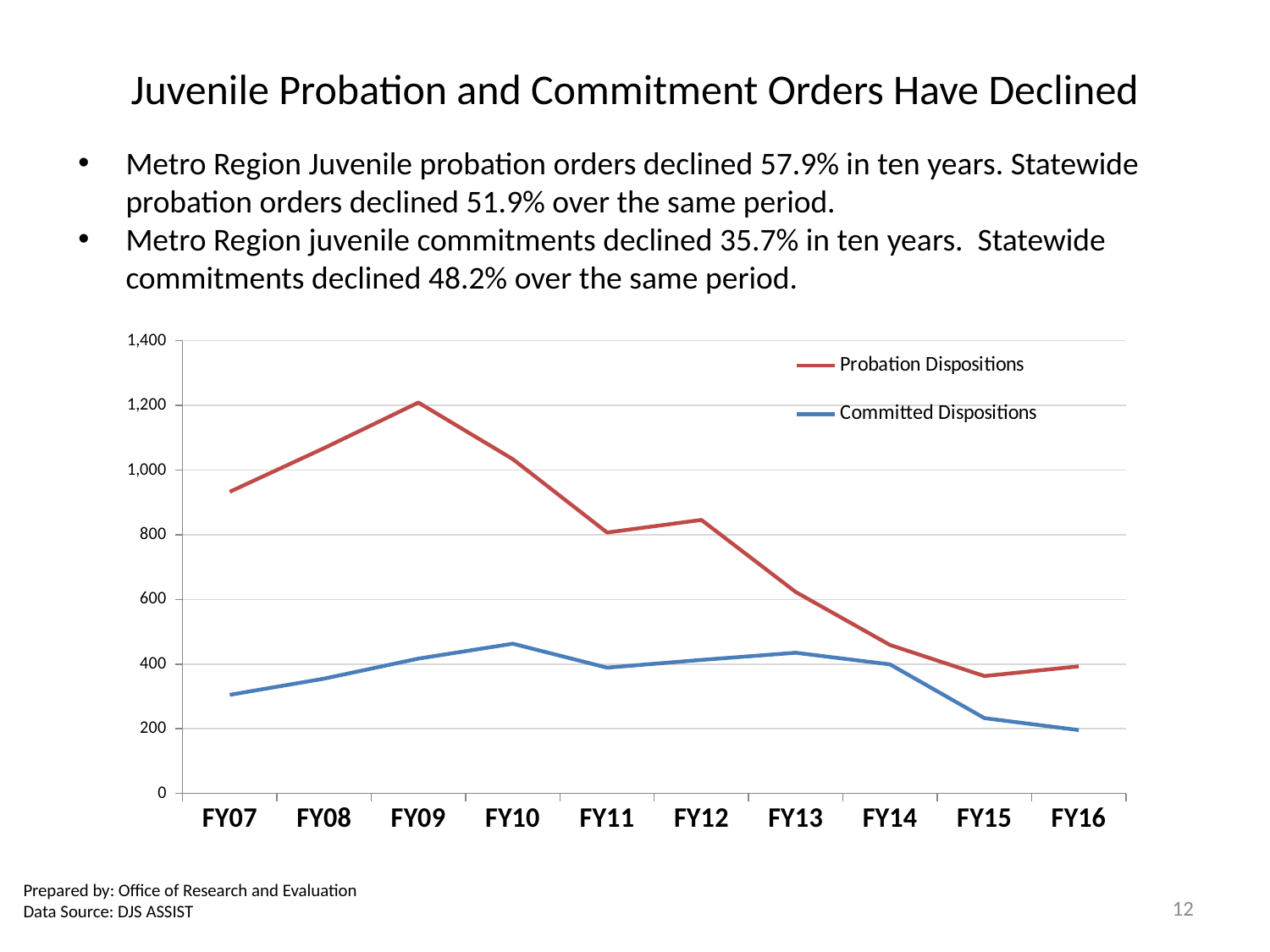
What colour is the line for Committed Dispositions? Blue What kind of chart is shown on the slide? Line chart In which fiscal year do Probation Dispositions reach their lowest value? FY15 In which fiscal year do Probation Dispositions reach their highest value? FY09 In which fiscal year do Committed Dispositions reach their lowest value? FY16 How many fiscal years are plotted along the x axis of the chart? 10 In FY07, which series has the larger value, Probation Dispositions or Committed Dispositions? Probation Dispositions Is the value for Committed Dispositions in FY07 greater or less than 400? less Is the value for Probation Dispositions in FY14 greater or less than 600? less Is the value for Probation Dispositions in FY09 greater or less than 1,000? greater How many series does the chart's legend list? 2 Overall, do Probation Dispositions rise or fall from FY07 to FY16? Fall